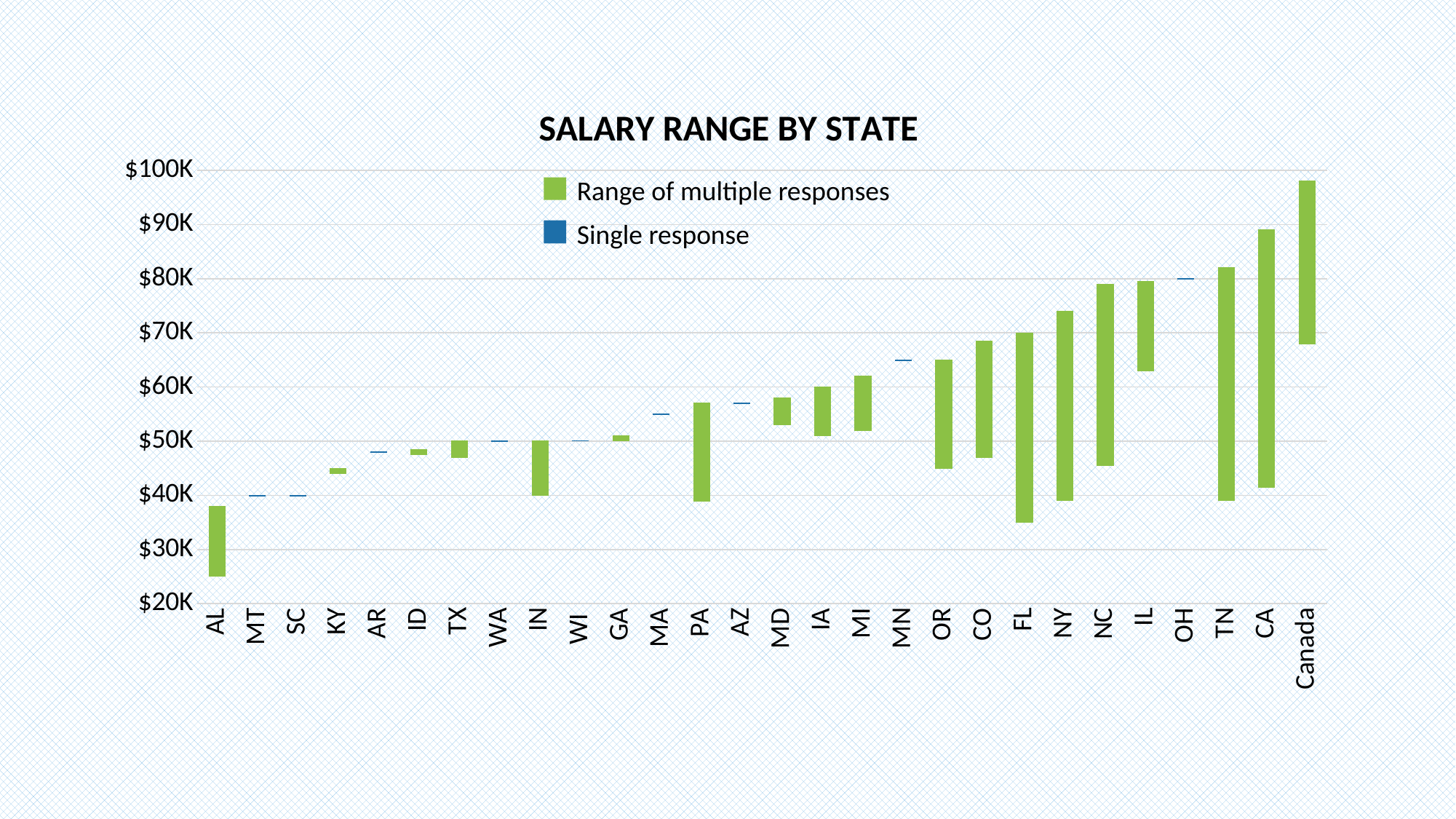
Which has a higher top of its salary range, CA or TN? CA How many states/regions are shown along the x axis? 28 What is the single-response salary value for WA? $50K What is the title of the chart? SALARY RANGE BY STATE Is the bottom of the salary range for FL greater or less than $40K? less Which category has the highest top of its salary range? Canada Is the top of the salary range for Canada greater or less than $90K? greater Which category has the lowest bottom of its salary range? AL How many series does the legend list? 2 What is the single-response salary value for MT? $40K What is the single-response salary value for OH? $80K What kind of chart is shown on the slide? Bar chart